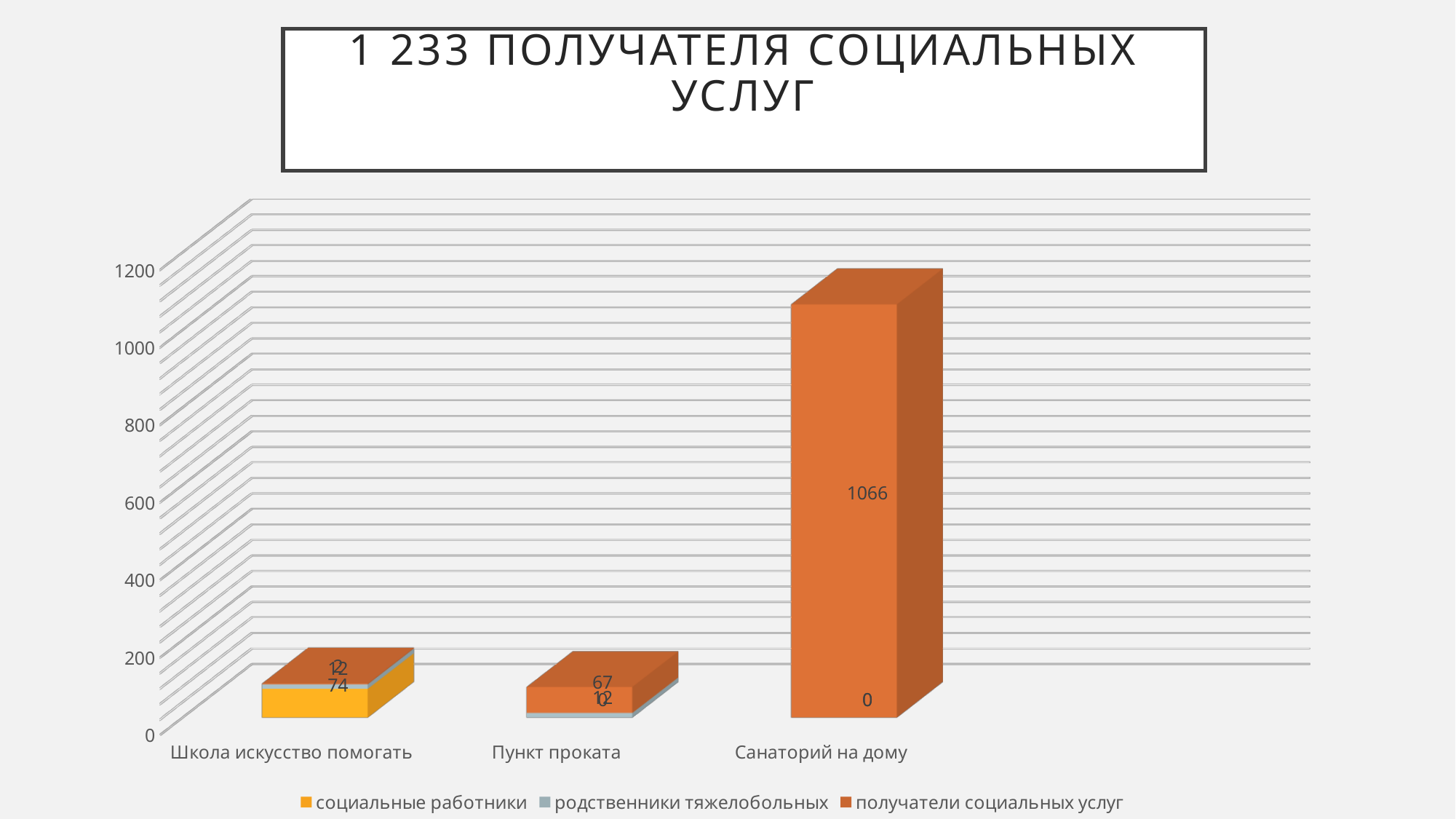
What is the difference between получатели социальных услуг for Санаторий на дому (1066) and for Пункт проката (67)? 999 Is the total height of the Пункт проката bar greater or less than 200? less What is the value for получатели социальных услуг in the Санаторий на дому category? 1066 What is the value for социальные работники in the Школа искусство помогать category? 74 Which category has the tallest bar? Санаторий на дому What type of chart is shown on the slide? bar chart What is the value for получатели социальных услуг in the Пункт проката category? 67 How many series does the legend list? 3 What value is labelled at the bottom of the Санаторий на дому bar? 0 How many categories are shown on the x axis? 3 Which is larger: получатели социальных услуг for Санаторий на дому or for Пункт проката? Санаторий на дому Is the total height of the Санаторий на дому bar greater or less than 1000? greater